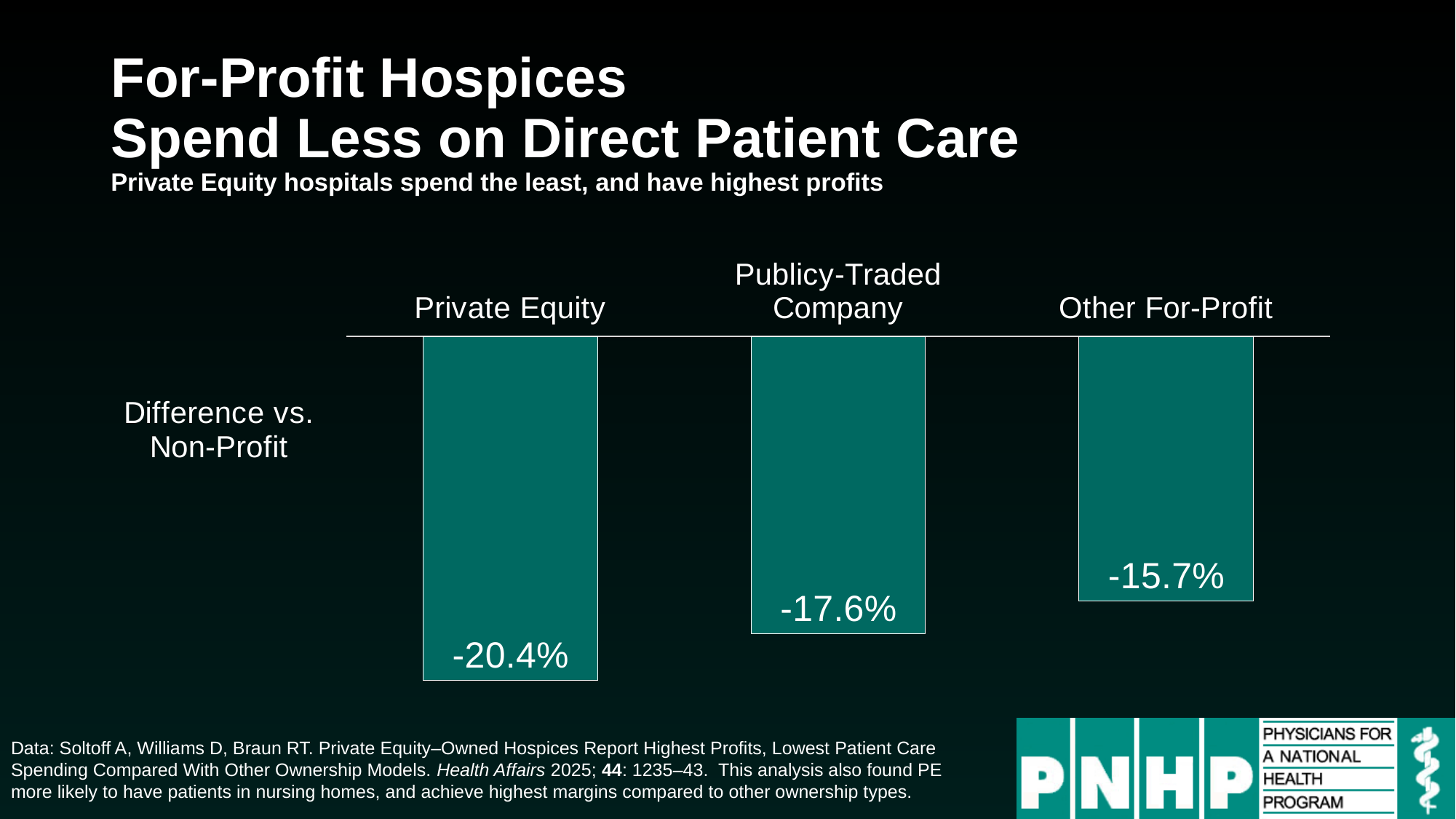
What kind of chart is shown on the slide? Bar chart Which category has the highest (least negative) value? Other For-Profit How many categories are plotted in the chart? 3 Which category has the lowest (most negative) value? Private Equity What is the value shown for Other For-Profit? -15.7% Which bar extends further below the baseline, Private Equity or Other For-Profit? Private Equity What is the difference between the Private Equity value and the Other For-Profit value? 4.7 percentage points What is the difference between the Private Equity value and the Publicy-Traded Company value? 2.8 percentage points What is the value shown for Private Equity? -20.4% What is the difference between the Publicy-Traded Company value and the Other For-Profit value? 1.9 percentage points What is the value shown for Publicy-Traded Company? -17.6% What does the label to the left of the bars say the values represent? Difference vs. Non-Profit